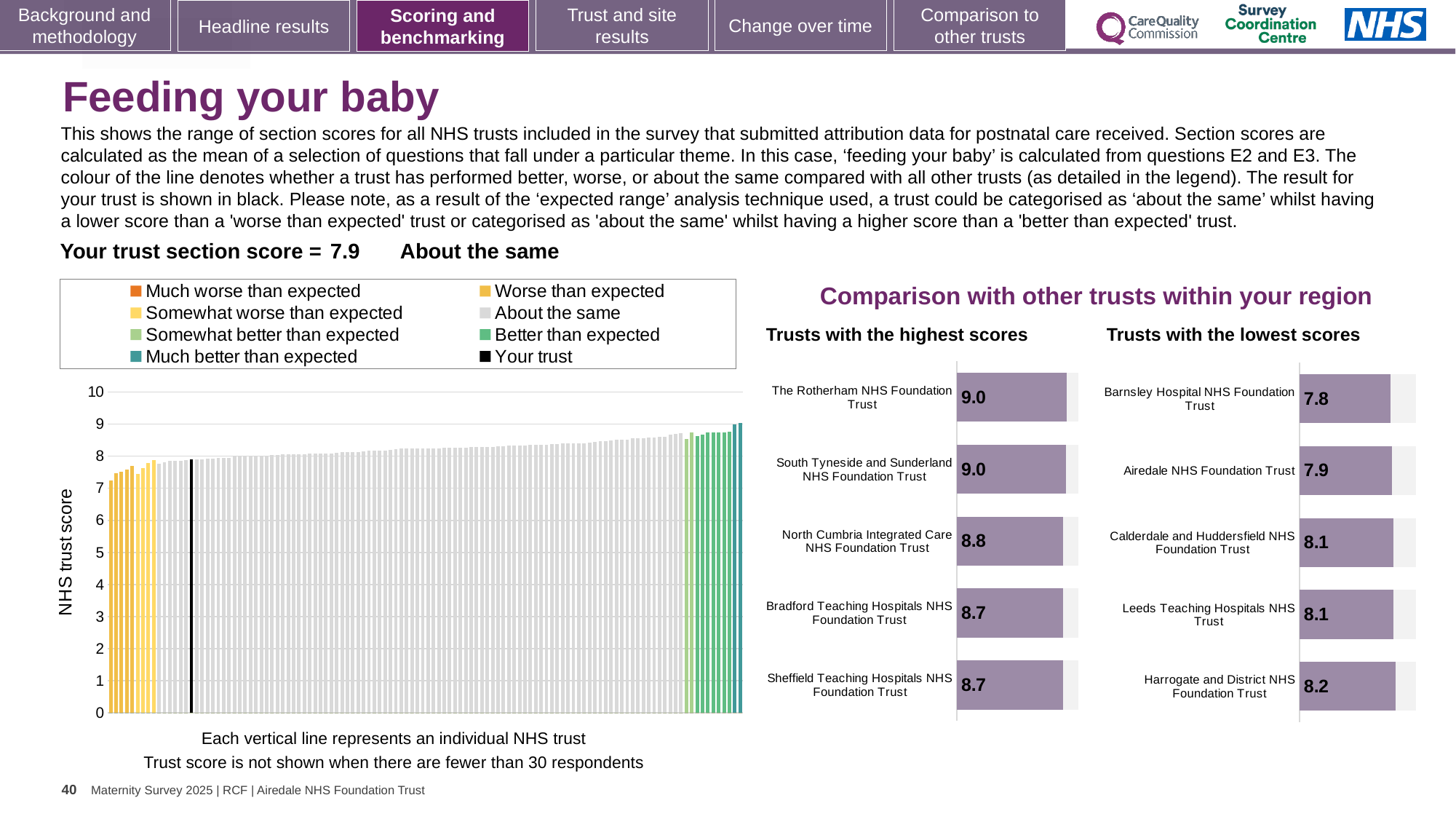
How many entries does the legend of the 'NHS trust score' chart on the left list? 8 In the 'Trusts with the lowest scores' chart, which trust has the lowest score? Barnsley Hospital NHS Foundation Trust In the 'Trusts with the highest scores' chart, what is the score for Bradford Teaching Hospitals NHS Foundation Trust? 8.7 In the 'Trusts with the lowest scores' chart, what is the score for Airedale NHS Foundation Trust? 7.9 In the 'NHS trust score' chart on the left, is the value for the black 'Your trust' bar greater or less than 7? greater In the 'Trusts with the highest scores' chart, what is the difference between the score for The Rotherham NHS Foundation Trust and the score for Sheffield Teaching Hospitals NHS Foundation Trust? 0.3 In the 'Trusts with the lowest scores' chart, which trust has the highest score? Harrogate and District NHS Foundation Trust In the 'Trusts with the lowest scores' chart, what is the difference between the score for Harrogate and District NHS Foundation Trust and the score for Barnsley Hospital NHS Foundation Trust? 0.4 In the 'Trusts with the highest scores' chart, what is the score for North Cumbria Integrated Care NHS Foundation Trust? 8.8 In the 'Trusts with the highest scores' chart, which has the larger score: North Cumbria Integrated Care NHS Foundation Trust or Bradford Teaching Hospitals NHS Foundation Trust? North Cumbria Integrated Care NHS Foundation Trust What kind of chart is the 'NHS trust score' chart on the left of the slide? Bar chart How many trusts are listed in the 'Trusts with the lowest scores' chart? 5